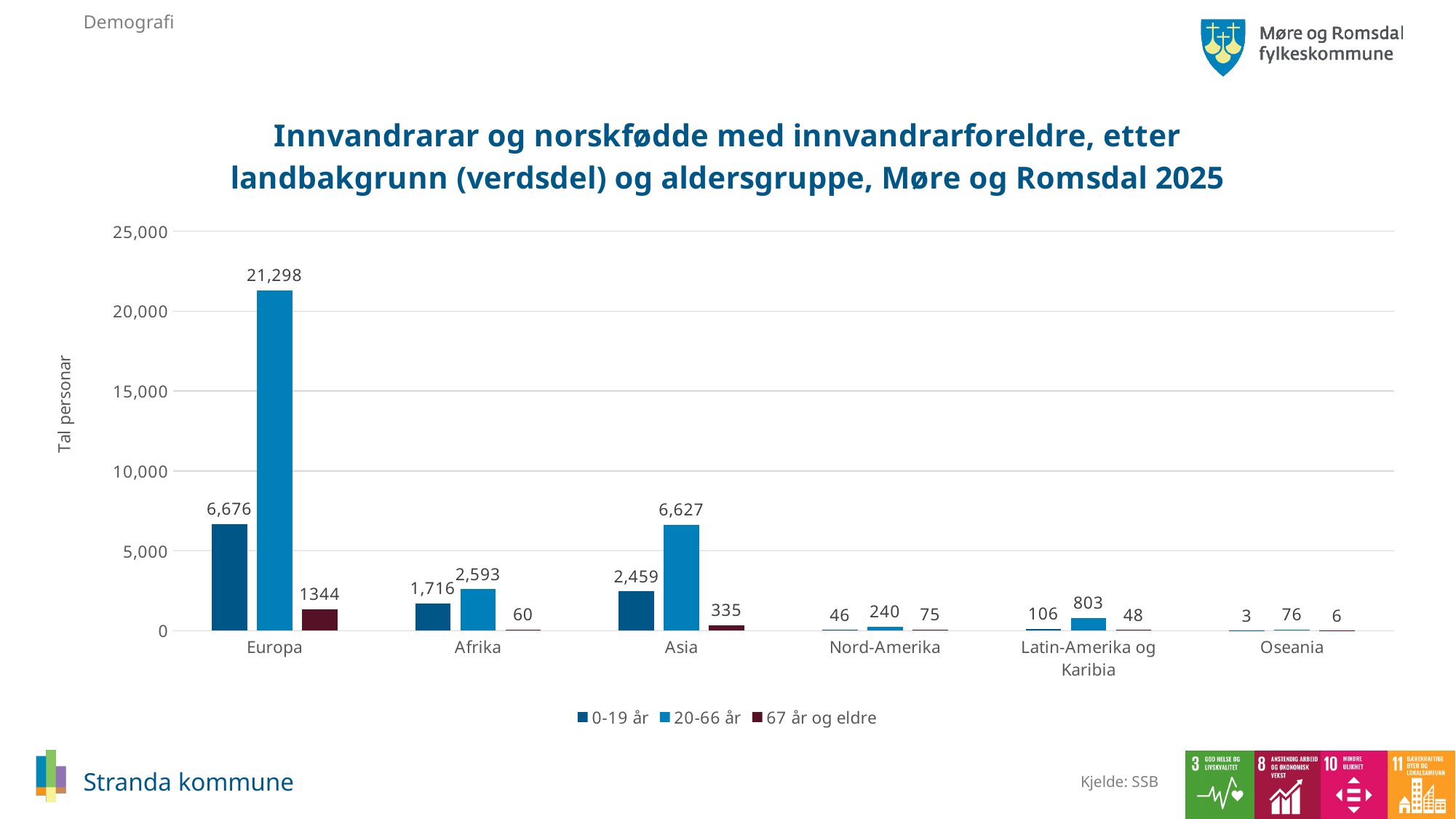
What is the value for the 20-66 år series for Latin-Amerika og Karibia? 803 What kind of chart is shown on the slide? Bar chart What is the value for the 20-66 år series for Europa? 21,298 Is the value for the 20-66 år series for Europa greater or less than 20,000? greater How many categories are shown on the x axis? 6 Which category has the lowest value for the 0-19 år series? Oseania What is the difference between the 20-66 år value and the 0-19 år value for Europa? 14,622 What is the value for the 0-19 år series for Asia? 2,459 Which category has the highest value for the 20-66 år series? Europa What is the value for the 67 år og eldre series for Afrika? 60 How many series does the legend list? 3 Which is larger: the 0-19 år value for Europa or the 20-66 år value for Asia? 0-19 år value for Europa